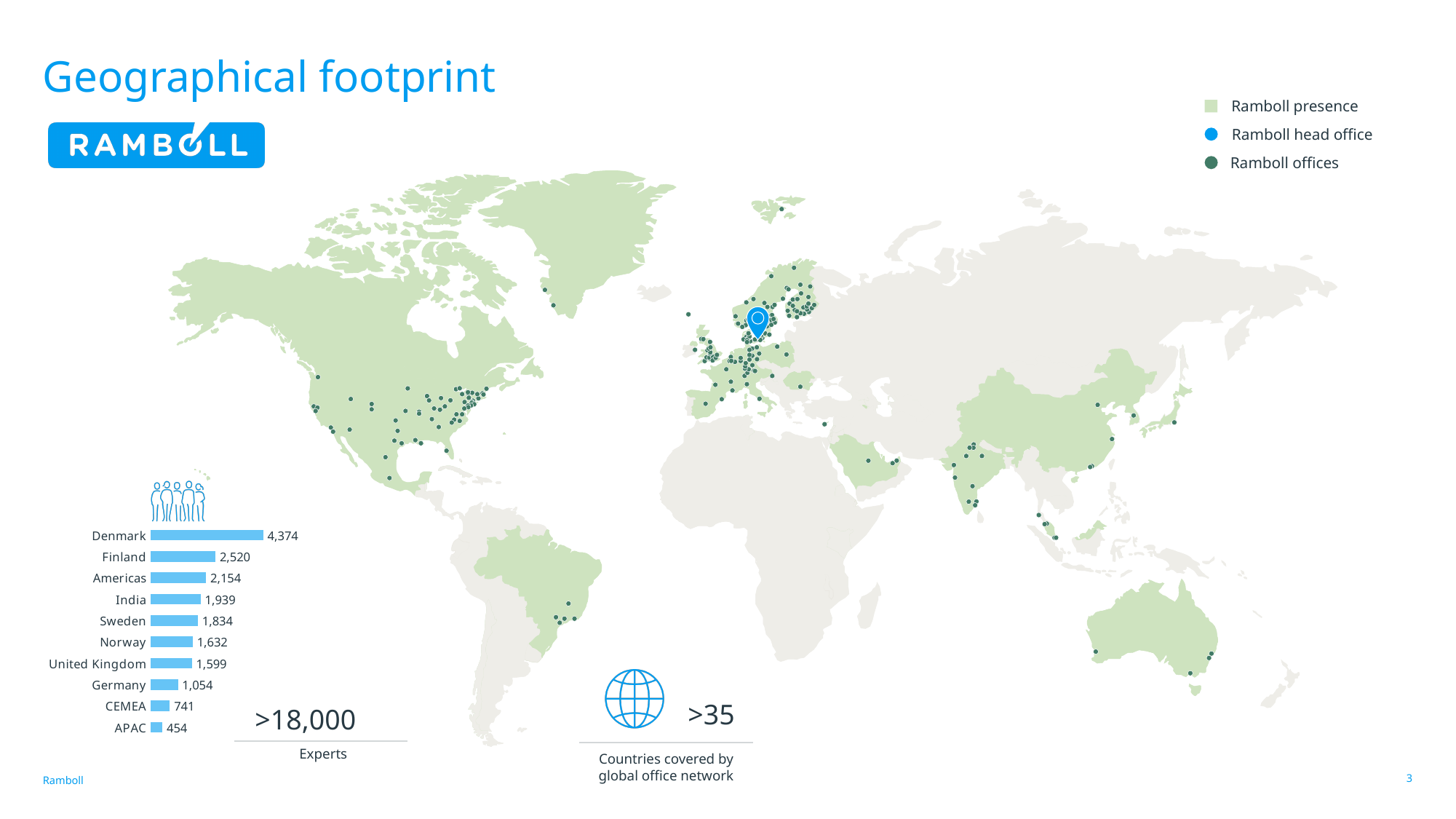
In the bar chart, what is the difference between the values for Sweden and Norway? 202 In the bar chart, do the values increase or decrease going from the top bar to the bottom bar? Decrease In the bar chart, what is the value for Denmark? 4,374 In the bar chart, what is the value for United Kingdom? 1,599 What kind of chart is shown at the bottom left of the slide? Bar chart Which category has the lowest value in the bar chart? APAC In the bar chart, what is the value for CEMEA? 741 In the bar chart, which is larger, the value for Americas or the value for Germany? Americas In the bar chart, what is the value for India? 1,939 Which category has the highest value in the bar chart? Denmark How many categories are shown in the bar chart? 10 In the bar chart, what is the difference between the values for Denmark and Finland? 1,854